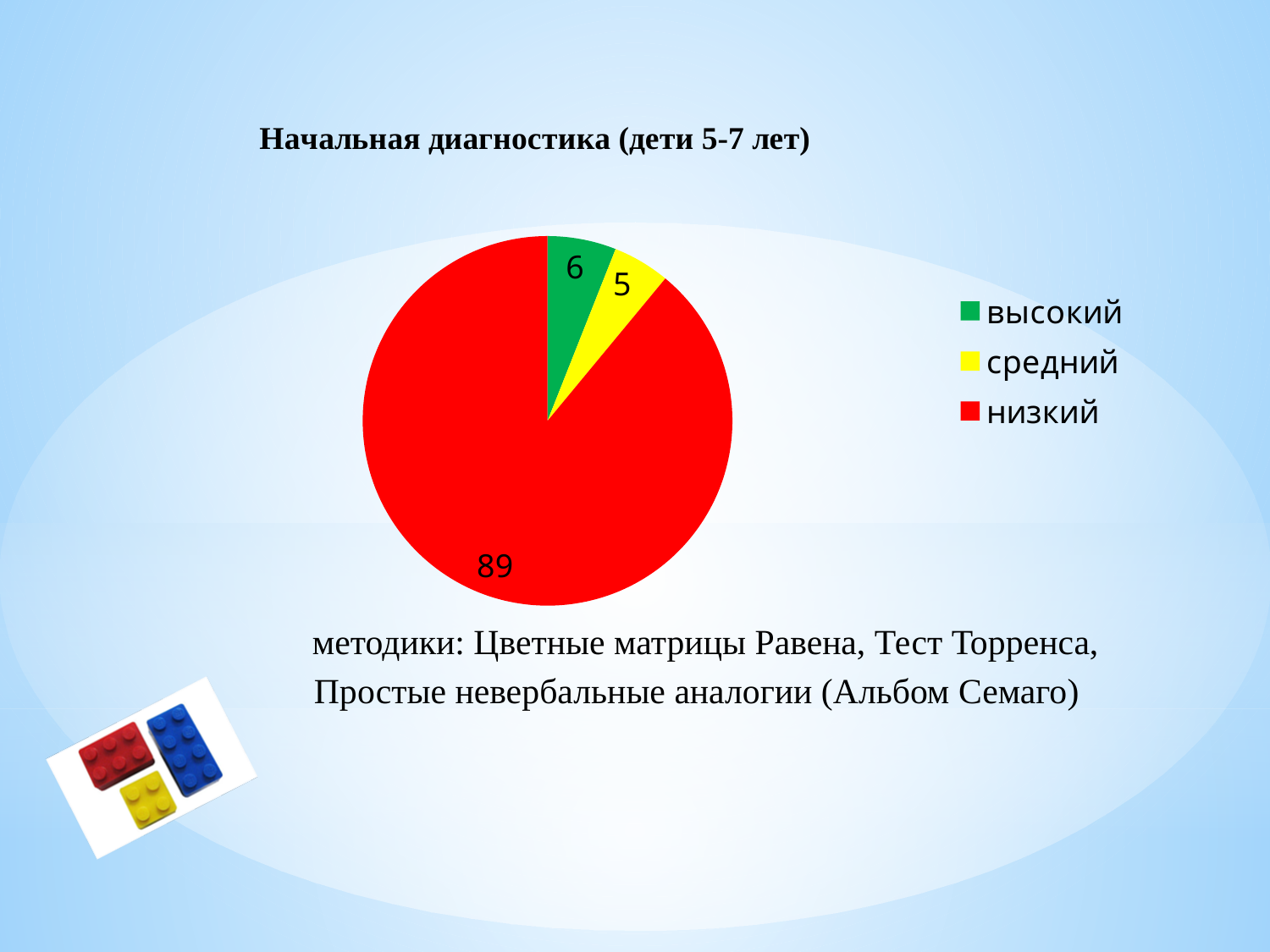
Which is larger, the value for "высокий" or the value for "средний"? высокий What is the value for the "средний" slice? 5 What is the value for the "высокий" slice? 6 Which category has the smallest slice of the pie? средний What kind of chart is shown on the slide? pie chart What is the difference between the values for "низкий" and "высокий"? 83 Which category has the largest slice of the pie? низкий What share of the pie does the "низкий" slice represent? 89% How many slices does the pie chart have? 3 What colour is the "средний" slice in the pie chart? yellow What is the value for the "низкий" slice? 89 What is the difference between the values for "высокий" and "средний"? 1